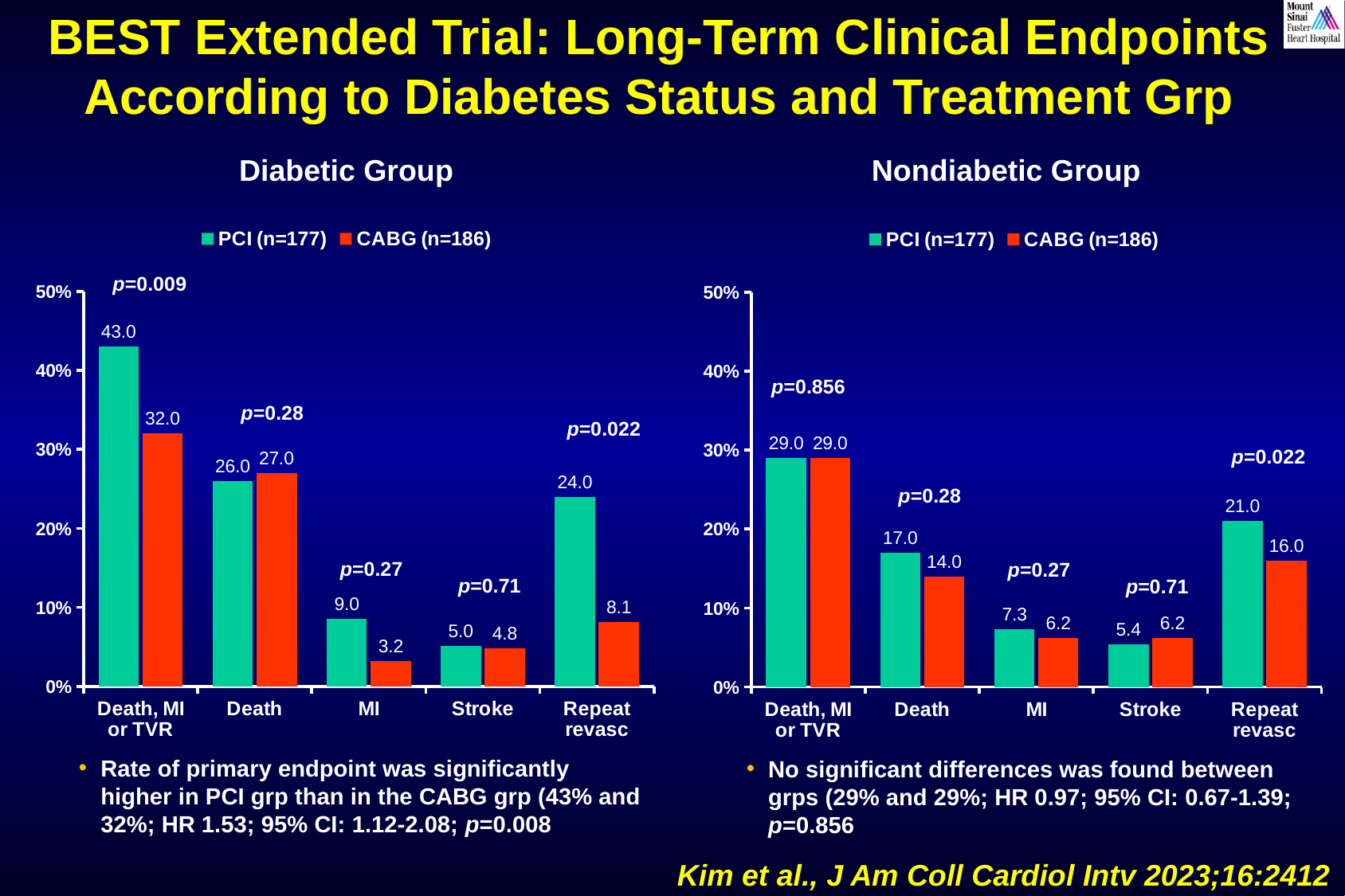
In the Diabetic Group chart, which is larger for Death: the PCI value or the CABG value? CABG In the Nondiabetic Group chart, what is the PCI value for Stroke? 5.4 How many categories are shown on the x axis of the Nondiabetic Group chart? 5 How many series does the legend of the Diabetic Group chart list? 2 In the Diabetic Group chart, which category has the highest PCI value? Death, MI or TVR In the Diabetic Group chart, what is the difference between the PCI and CABG values for Repeat revasc? 15.9 In the Nondiabetic Group chart, what is the difference between the PCI and CABG values for Death? 3.0 In the Nondiabetic Group chart, what is the CABG value for Repeat revasc? 16.0 In the Diabetic Group chart, what is the PCI value for Death, MI or TVR? 43.0 In the Diabetic Group chart, what is the CABG value for MI? 3.2 What kind of chart is the Diabetic Group chart? Bar chart